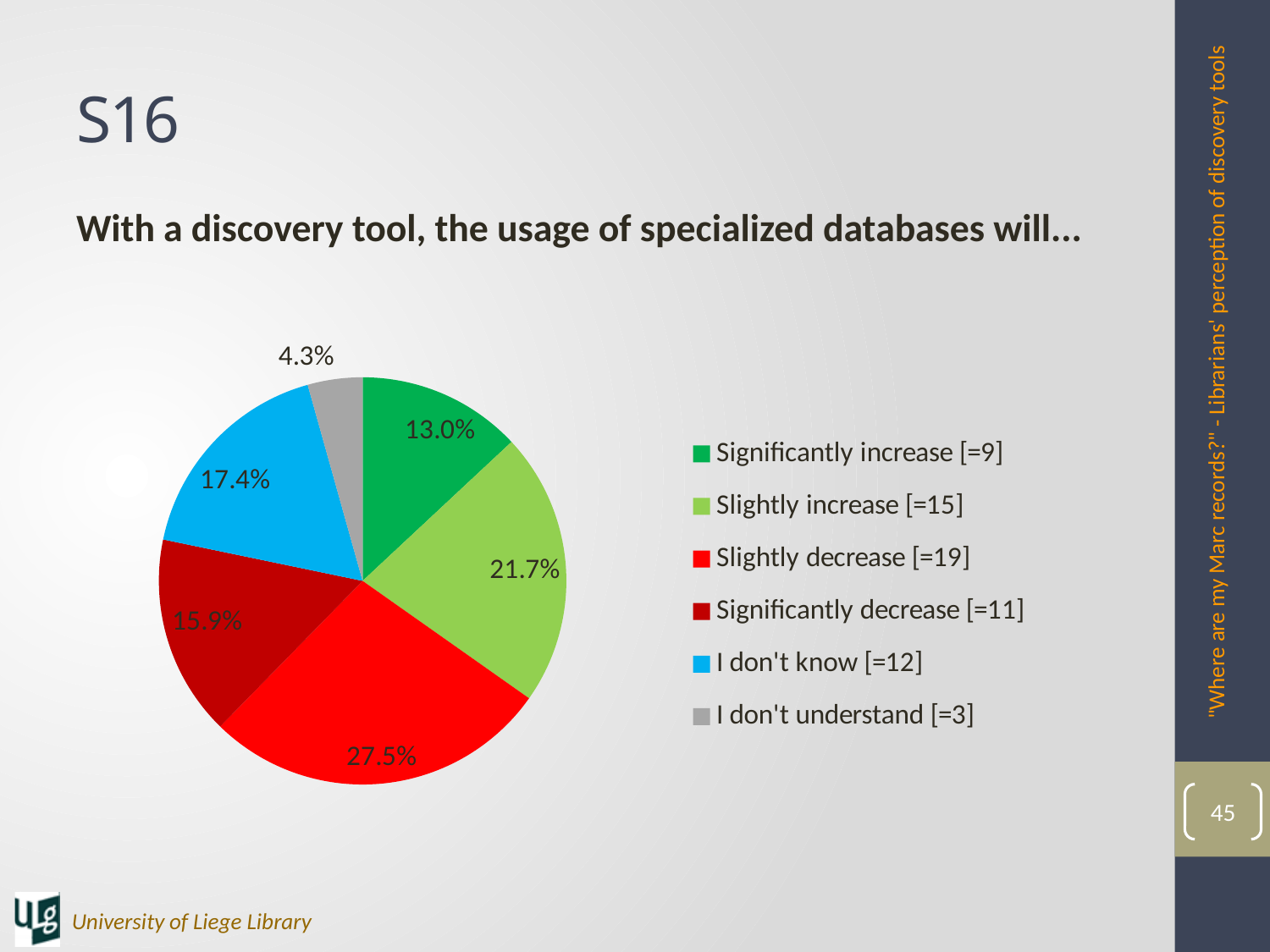
Which category has the smallest slice of the pie? I don't understand What share of the pie is labelled for "I don't know"? 17.4% What is the difference in percentage points between the "Slightly decrease" slice and the "Slightly increase" slice? 5.8 What share of the pie is labelled for "Significantly increase"? 13.0% Which slice is larger: "Slightly increase" or "Significantly decrease"? Slightly increase What kind of chart is shown on the slide? pie chart Which category has the largest slice of the pie? Slightly decrease How many respondents does the legend give for "Slightly decrease"? 19 What share of the pie is labelled for "I don't understand"? 4.3% What colour is the "I don't know" slice? light blue How many slices does the pie chart have? 6